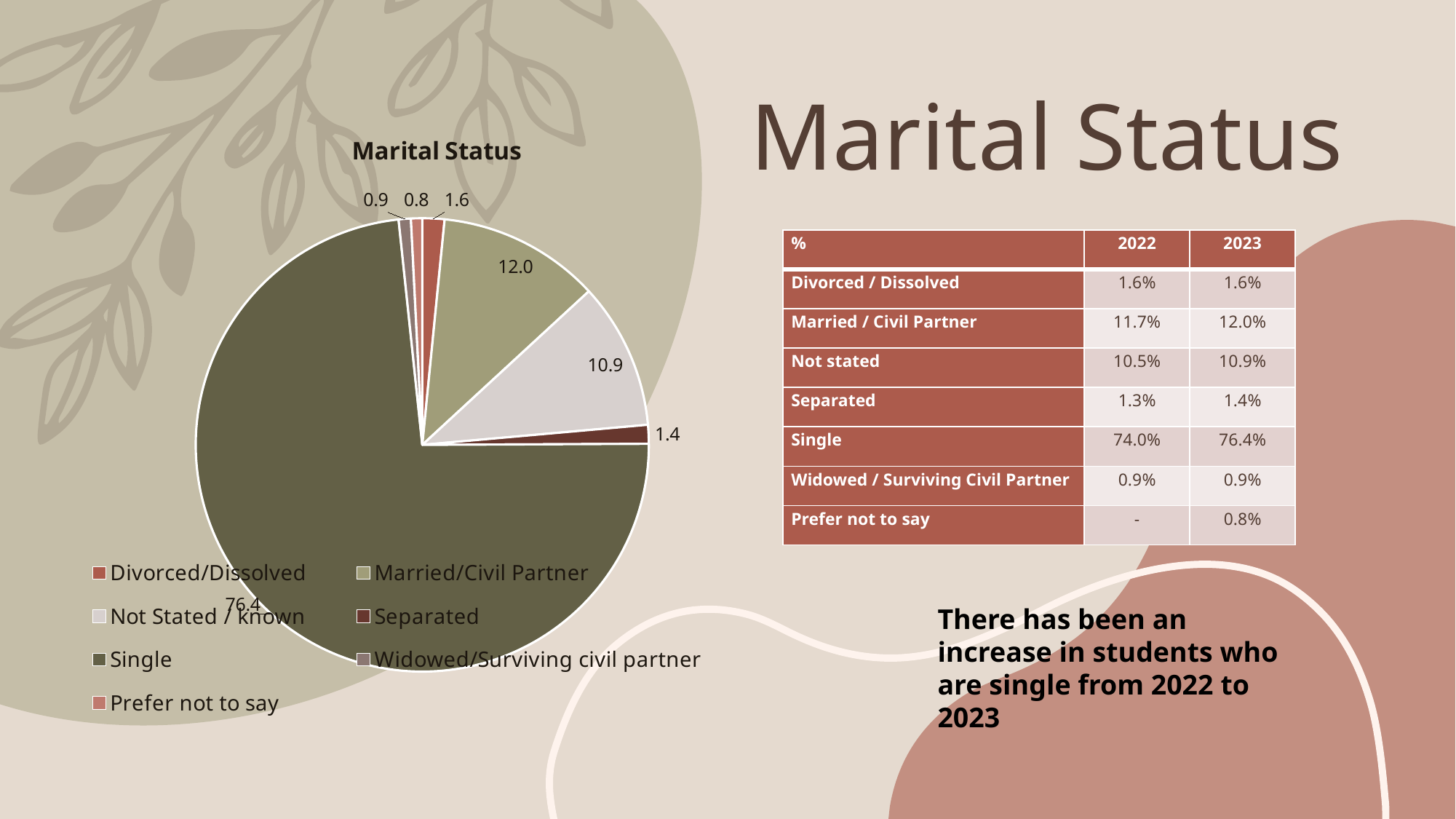
What value does the chart show for Married/Civil Partner? 12.0 What value does the chart show for Single? 76.4 What is the title of the chart? Marital Status Which category has the largest slice of the pie? Single What value does the chart show for Separated? 1.4 How many categories does the legend of the pie chart list? 7 What value does the chart show for Not Stated / known? 10.9 What value does the chart show for Prefer not to say? 0.8 What is the difference between the values for Married/Civil Partner and Not Stated / known? 1.1 Which is larger, the slice for Divorced/Dissolved or the slice for Separated? Divorced/Dissolved What kind of chart is shown on the slide? pie chart Which category has the smallest slice of the pie? Prefer not to say